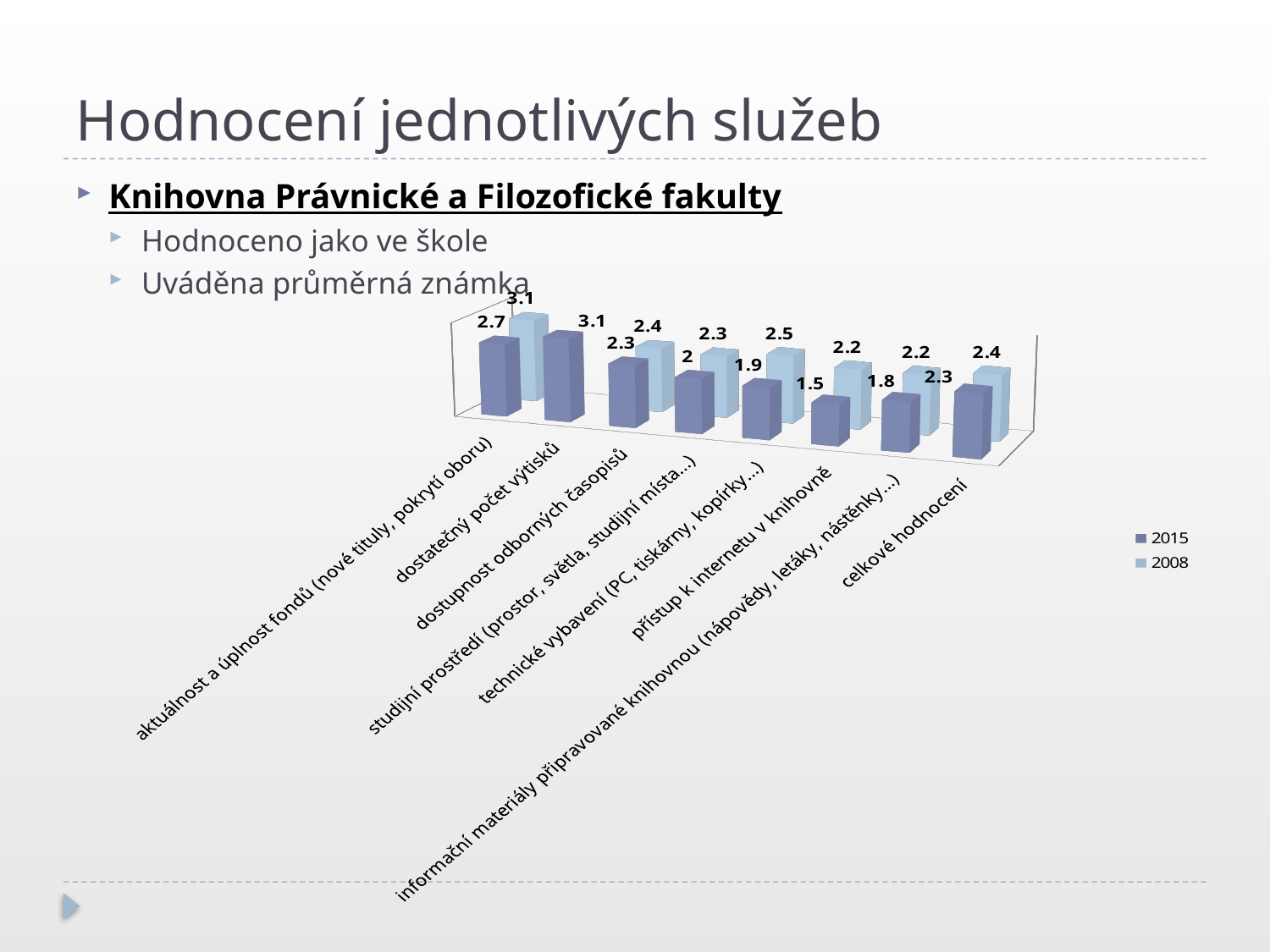
Which years are listed in the chart legend? 2015 and 2008 What is the 2015 value for 'aktuálnost a úplnost fondů (nové tituly, pokrytí oboru)'? 2.7 How many categories are shown on the x axis of the chart? 8 What is the 2008 value for 'celkové hodnocení'? 2.4 What is the 2015 value for 'celkové hodnocení'? 2.3 What type of chart is shown on the slide? bar chart What is the difference between the 2008 and 2015 values for 'přístup k internetu v knihovně'? 0.7 What is the 2015 value for 'přístup k internetu v knihovně'? 1.5 Which category has the highest 2015 value? dostatečný počet výtisků How many series does the chart legend list? 2 For 'technické vybavení (PC, tiskárny, kopírky...)', which is larger, the 2015 value or the 2008 value? 2008 Which category has the lowest 2015 value? přístup k internetu v knihovně